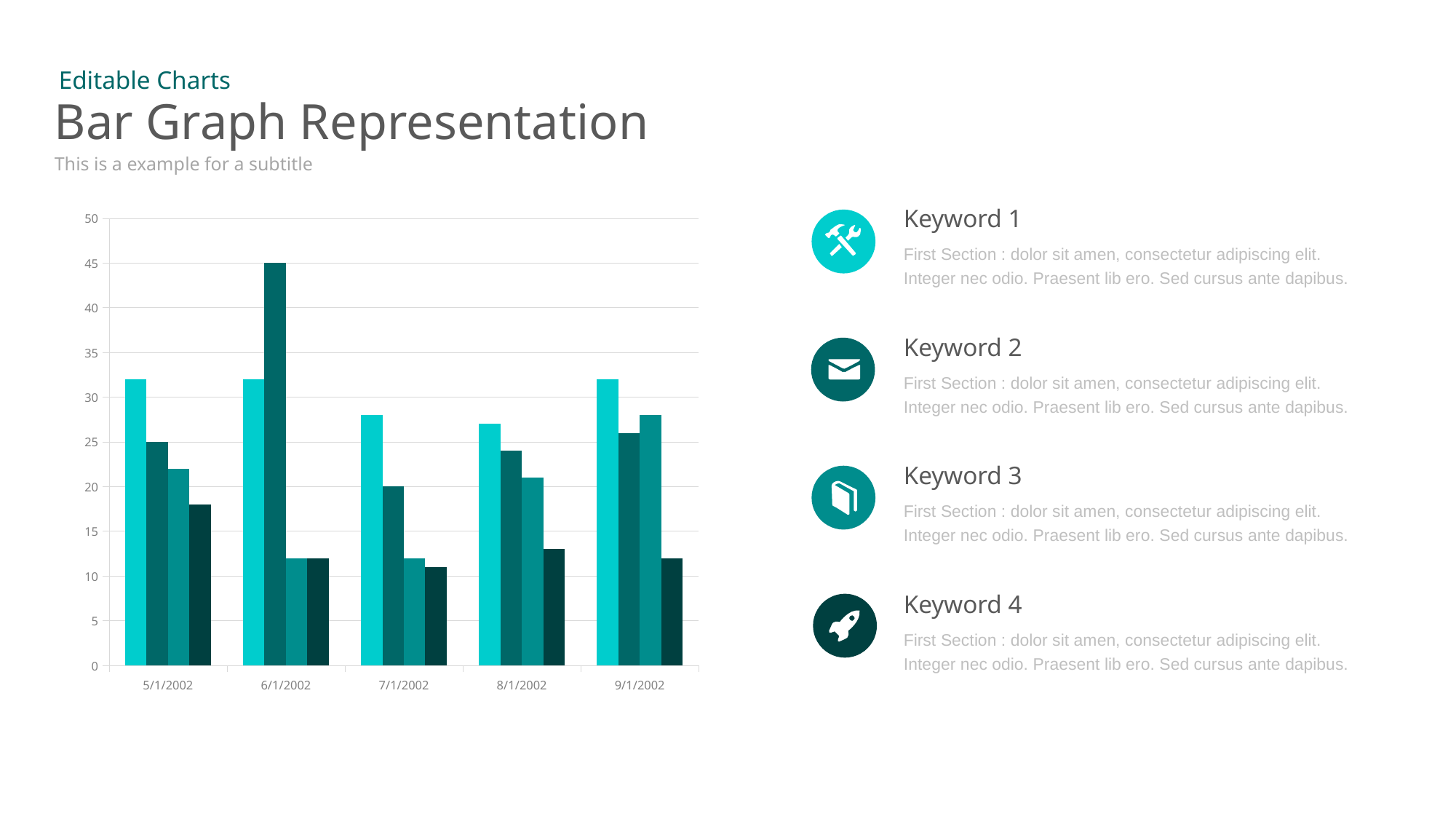
Is the value of the lightest (first) bar for 5/1/2002 greater or less than 30? greater Which date category contains the tallest bar in the chart? 6/1/2002 What is the highest value shown on the chart's vertical axis? 50 Which is larger: the lightest (first) bar for 9/1/2002 or the lightest (first) bar for 8/1/2002? 9/1/2002 Is the value of the lightest (first) bar for 7/1/2002 greater or less than 25? greater What kind of chart is shown on the slide? bar chart What is the value of the tallest bar in the 6/1/2002 group? 45 What is the title of the slide containing the chart? Bar Graph Representation How many bars are plotted for each date category in the chart? 4 Is the value of the darkest (last) bar for 6/1/2002 greater or less than 15? less How many date categories are shown on the x axis of the chart? 5